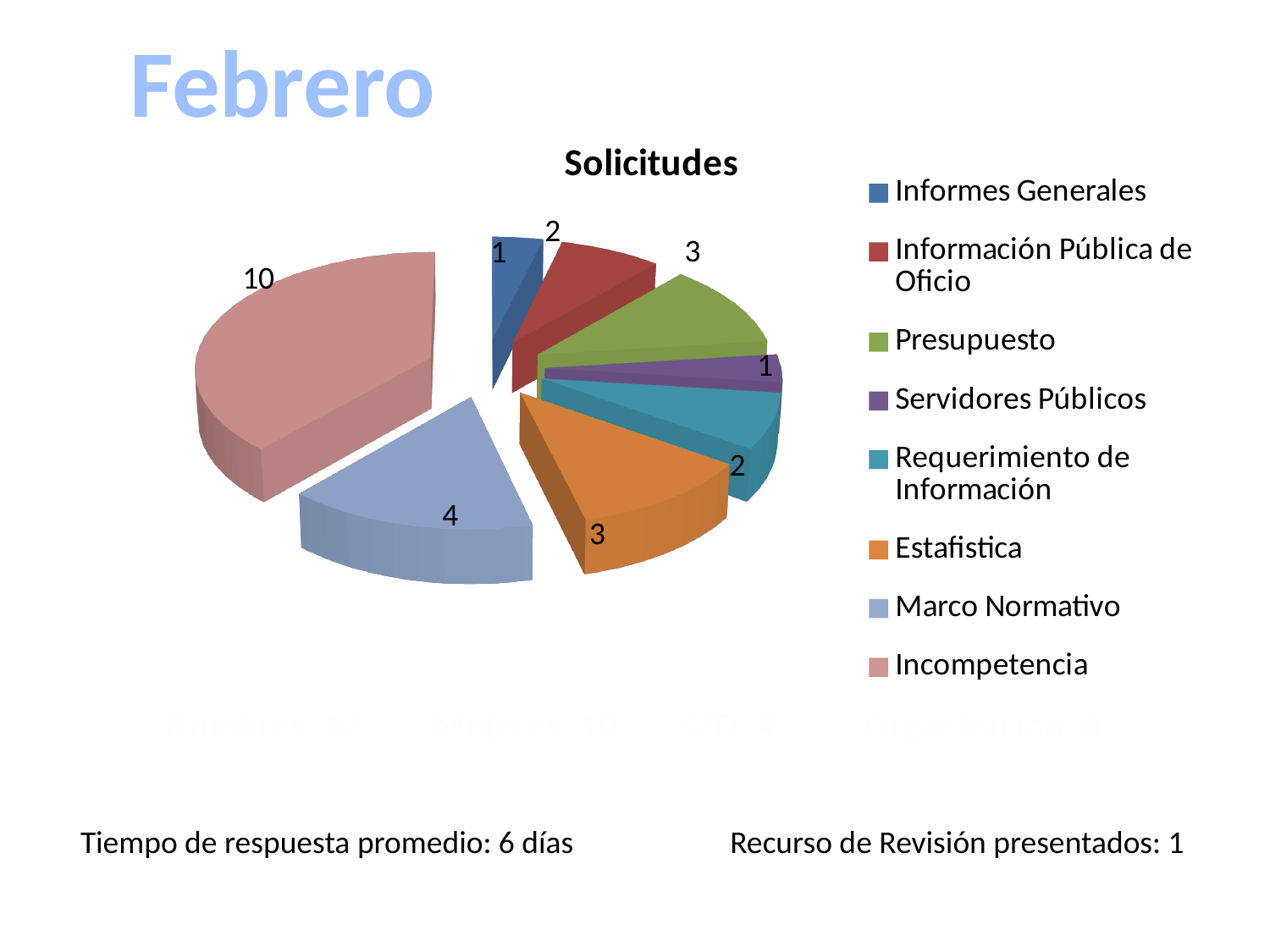
Which is larger in the Solicitudes chart, Estafistica or Información Pública de Oficio? Estafistica What type of chart is shown on the slide? Pie chart What is the title of the chart? Solicitudes How many categories does the legend of the Solicitudes chart list? 8 What is the value for Incompetencia in the Solicitudes chart? 10 What is the value for Marco Normativo in the Solicitudes chart? 4 What is the value for Presupuesto in the Solicitudes chart? 3 Which category has the largest slice in the Solicitudes chart? Incompetencia What is the difference between the values for Incompetencia and Marco Normativo? 6 Which categories have the smallest value in the Solicitudes chart? Informes Generales and Servidores Públicos What is the value for Requerimiento de Información in the Solicitudes chart? 2 What is the total of all slices in the Solicitudes chart? 26